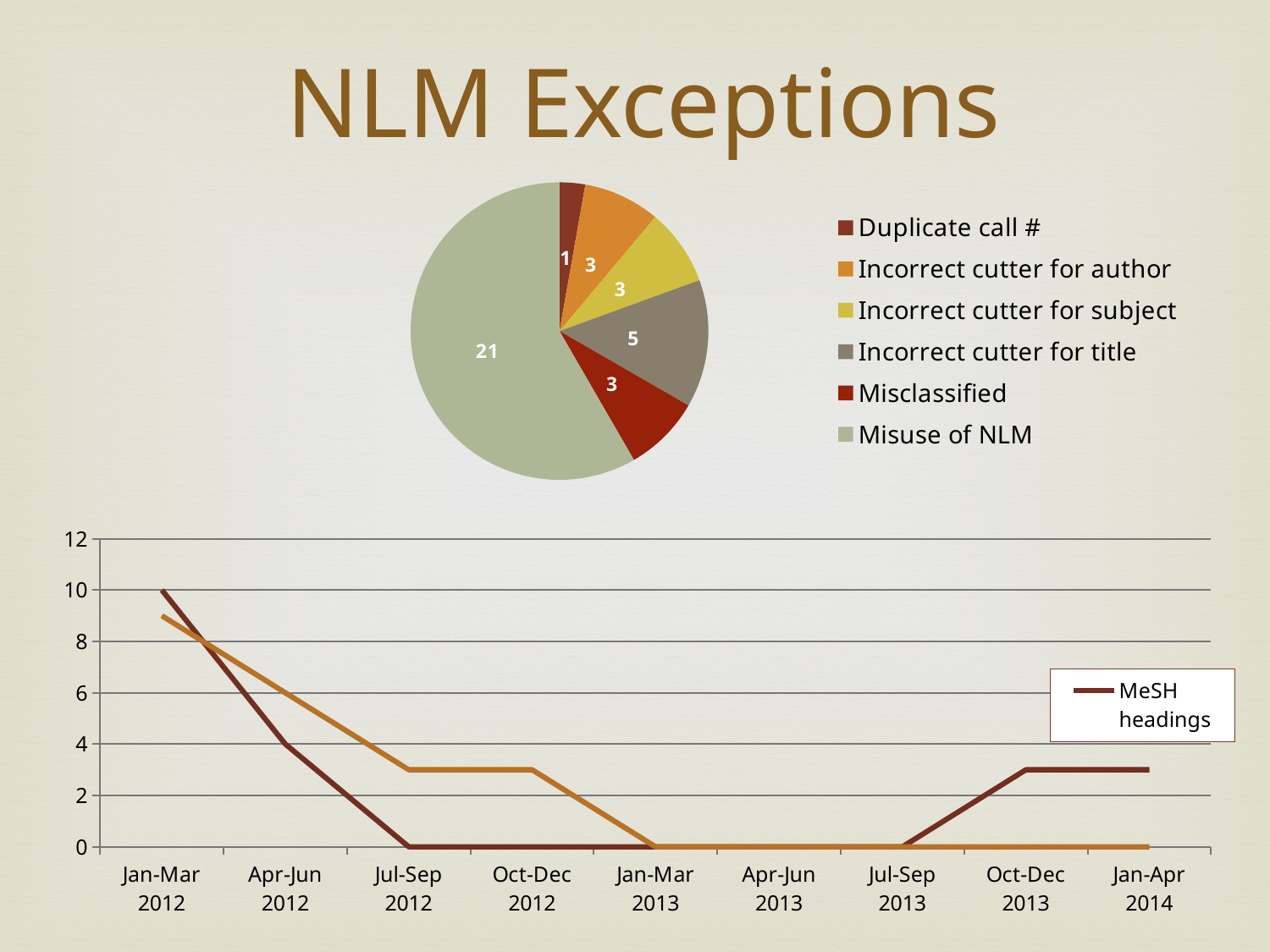
In the pie chart, what is the value for Duplicate call #? 1 In the line chart, what is the value for MeSH headings in Jan-Mar 2012? 10 What kind of chart is the lower chart on the slide? Line chart In the pie chart, what is the value for Misuse of NLM? 21 In the line chart, does the MeSH headings line rise or fall from Jan-Mar 2012 to Jul-Sep 2012? Fall In the pie chart, which category has the largest slice? Misuse of NLM In the pie chart, which category has the smallest slice? Duplicate call # How many categories does the pie chart's legend list? 6 How many time periods are shown on the x axis of the line chart? 9 In the pie chart, what is the difference between Misuse of NLM and Incorrect cutter for title? 16 In the pie chart, what is the value for Incorrect cutter for title? 5